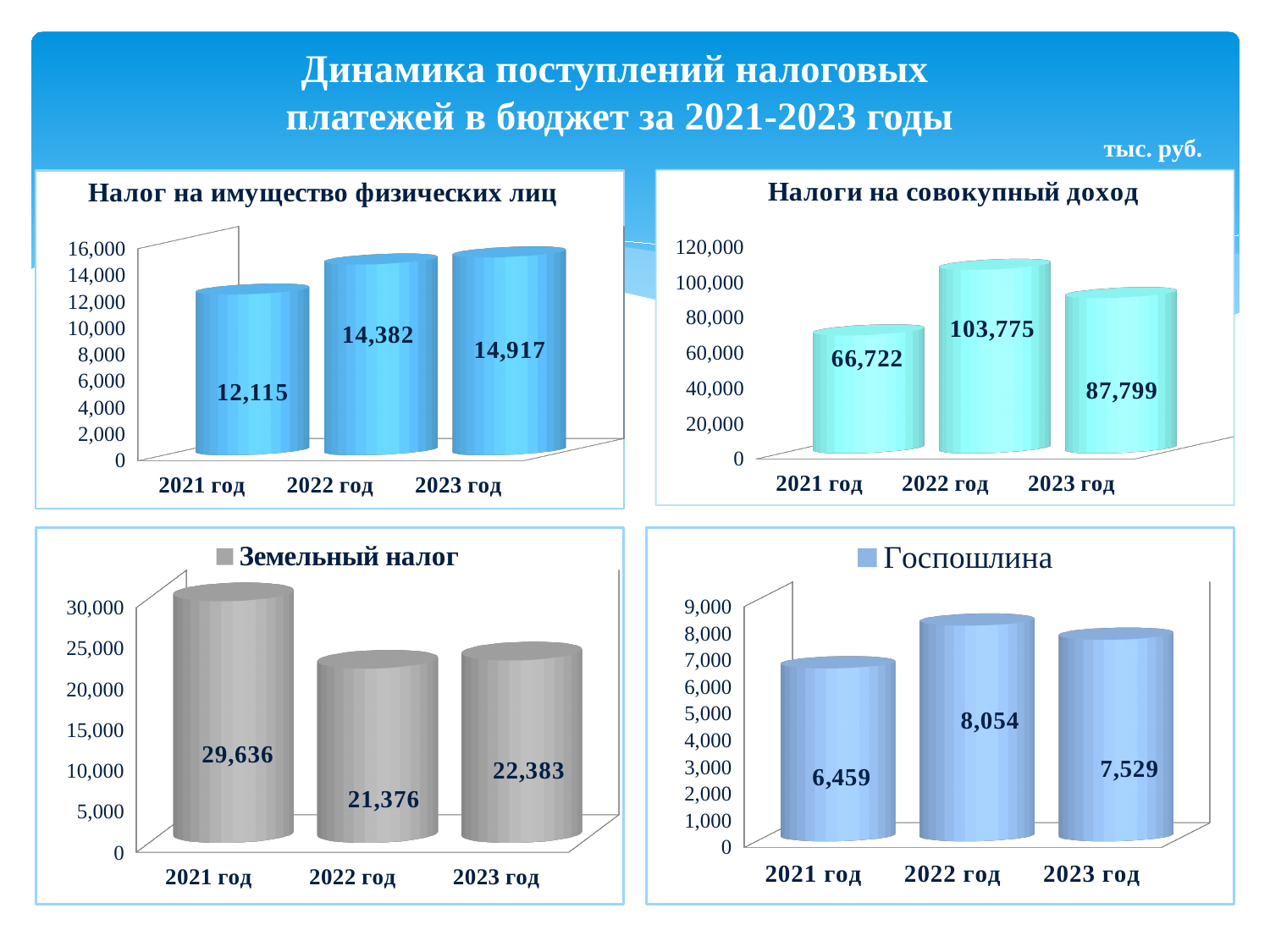
In the chart titled "Налог на имущество физических лиц", what is the value for 2021 год? 12,115 In the chart titled "Налоги на совокупный доход", which year has the highest value? 2022 год In the chart titled "Земельный налог", which year has the lowest value? 2022 год In the chart titled "Госпошлина", what is the difference between the values for 2022 год and 2023 год? 525 In the chart titled "Налог на имущество физических лиц", what is the difference between the values for 2023 год and 2021 год? 2,802 In the chart titled "Земельный налог", which is larger: the value for 2021 год or the value for 2023 год? 2021 год In the chart titled "Налог на имущество физических лиц", do the values rise or fall from 2021 год to 2023 год? rise In the chart titled "Госпошлина", what is the value for 2021 год? 6,459 In the chart titled "Земельный налог", what is the value for 2023 год? 22,383 How many categories are shown on the x axis of the chart titled "Госпошлина"? 3 What kind of chart is the chart titled "Налоги на совокупный доход"? bar chart In the chart titled "Налоги на совокупный доход", what is the value for 2022 год? 103,775